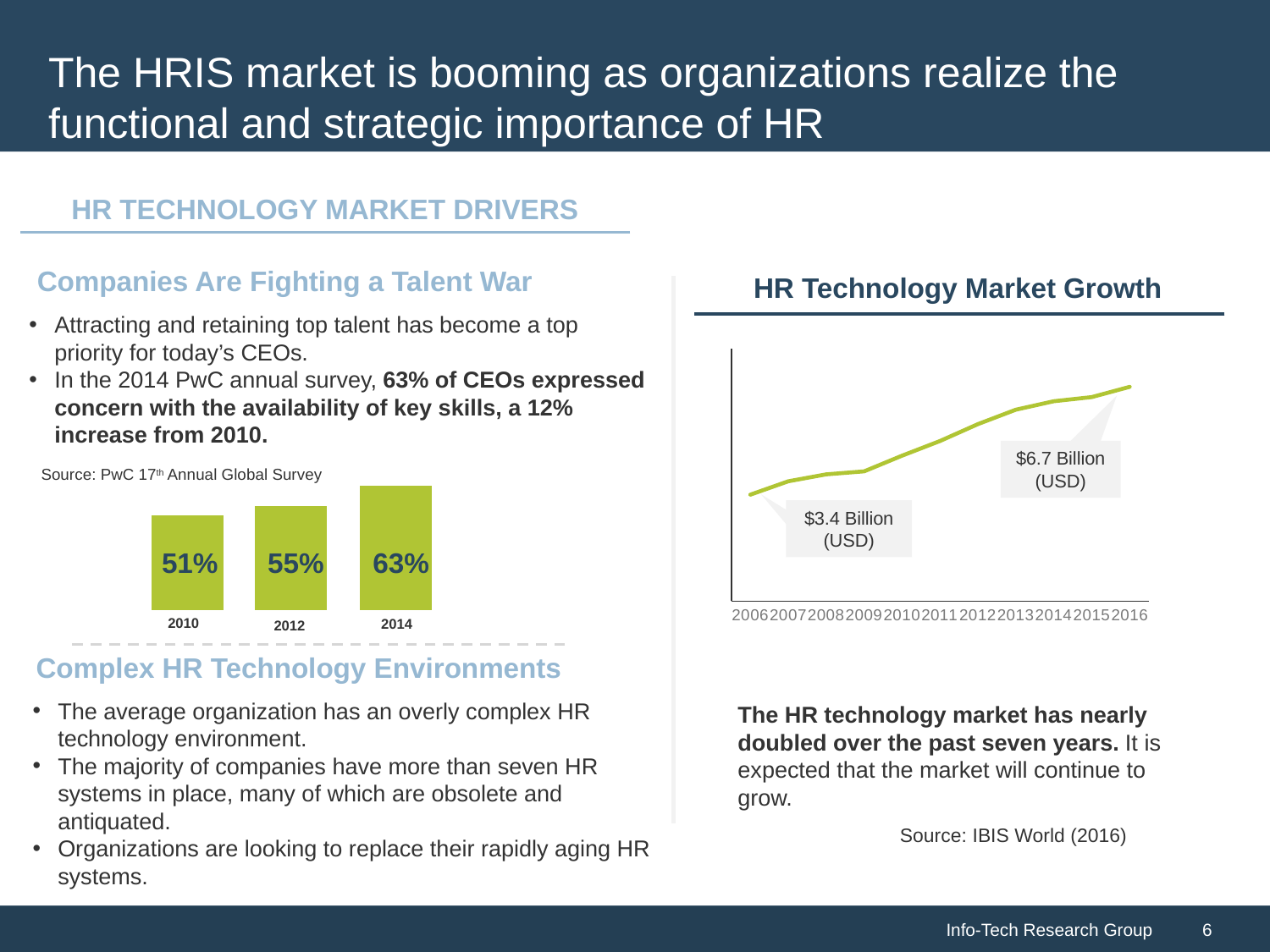
On the 'HR Technology Market Growth' chart, what value is labelled at the start of the line in 2006? $3.4 Billion (USD) On the bar chart on the left, what is the value for 2012? 55% On the bar chart on the left, what is the value for 2010? 51% On the bar chart on the left, what is the value for 2014? 63% On the bar chart on the left, what is the difference between the 2014 and 2010 values? 12% On the bar chart on the left, which year has the lowest value? 2010 On the 'HR Technology Market Growth' chart, does the line rise or fall from 2006 to 2016? rise On the bar chart on the left, how many bars are shown? 3 On the bar chart on the left, do the values rise or fall from 2010 to 2014? rise On the bar chart on the left, which year has the highest value? 2014 What kind of chart is the 'HR Technology Market Growth' chart? line chart On the 'HR Technology Market Growth' chart, what value is labelled at the end of the line in 2016? $6.7 Billion (USD)